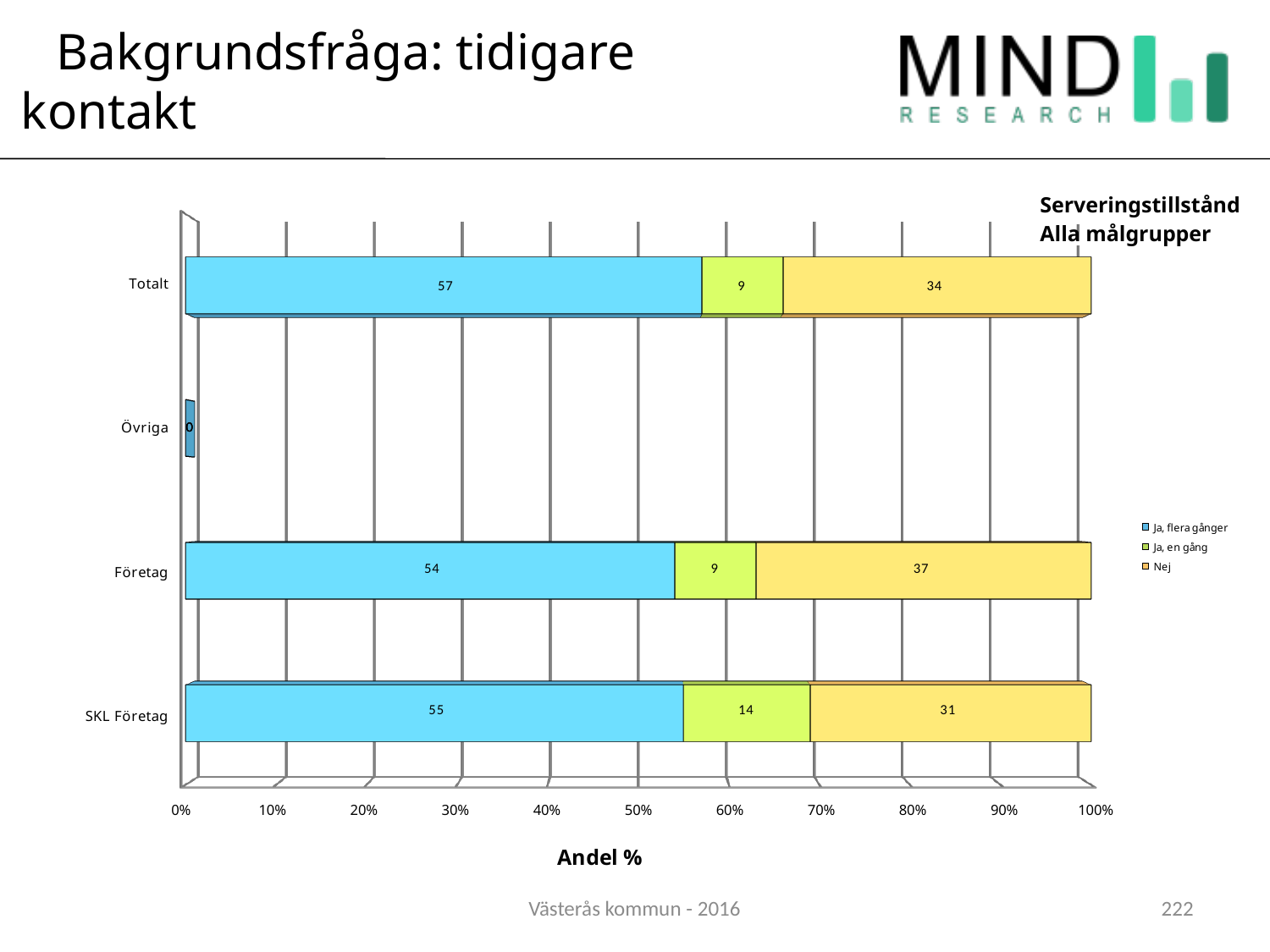
What kind of chart is shown on the slide? Stacked bar chart What is the value of "Ja, flera gånger" for Totalt? 57 How many series does the legend list? 3 Which category has the highest value for "Nej"? Företag What is the difference between the "Nej" values for Företag and Totalt? 3 What is the value of "Ja, en gång" for SKL Företag? 14 How many categories are shown on the y axis? 4 What is the value of "Nej" for Företag? 37 Which category has the highest value for "Ja, en gång"? SKL Företag Which is larger, the "Ja, flera gånger" value for Totalt or for Företag? Totalt What is the label of the x axis? Andel % What is the value of "Nej" for SKL Företag? 31